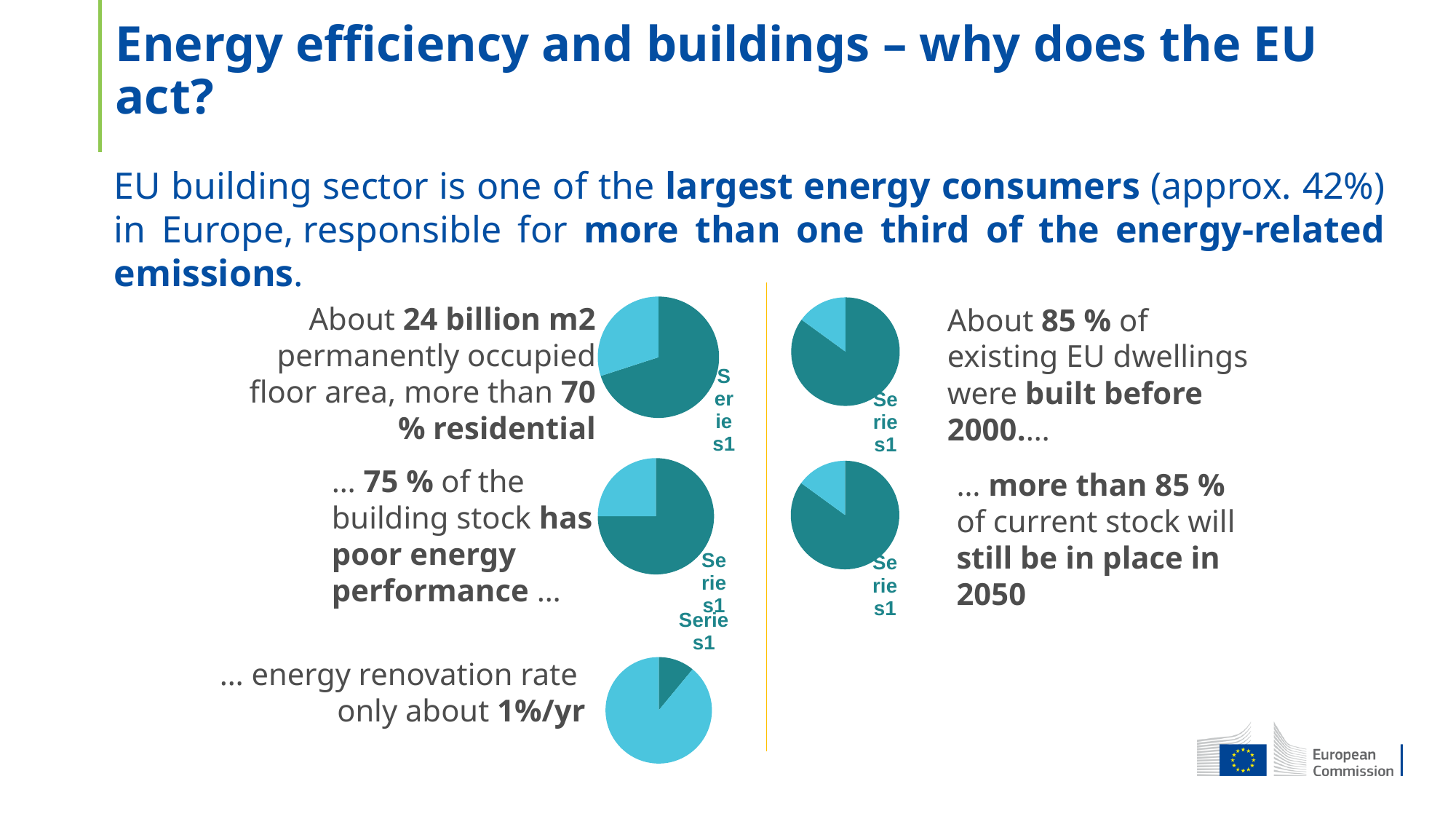
What kind of chart is used for the small graphics on this slide? pie chart In the pie chart next to the text 'About 85 % of existing EU dwellings were built before 2000', which slice is larger, the dark teal one or the light blue one? dark teal In the pie chart next to the text '75 % of the building stock has poor energy performance', which slice is larger, the dark teal one or the light blue one? dark teal How many slices does the pie chart next to the text 'energy renovation rate only about 1%/yr' have? 2 In the pie chart next to the text 'energy renovation rate only about 1%/yr', which slice is larger, the dark teal one or the light blue one? light blue How many pie charts are on the right side of the vertical divider line? 2 How many different colours are used in each pie chart? 2 How many pie charts are on the left side of the vertical divider line? 3 What legend label is printed beside the pie charts? Series1